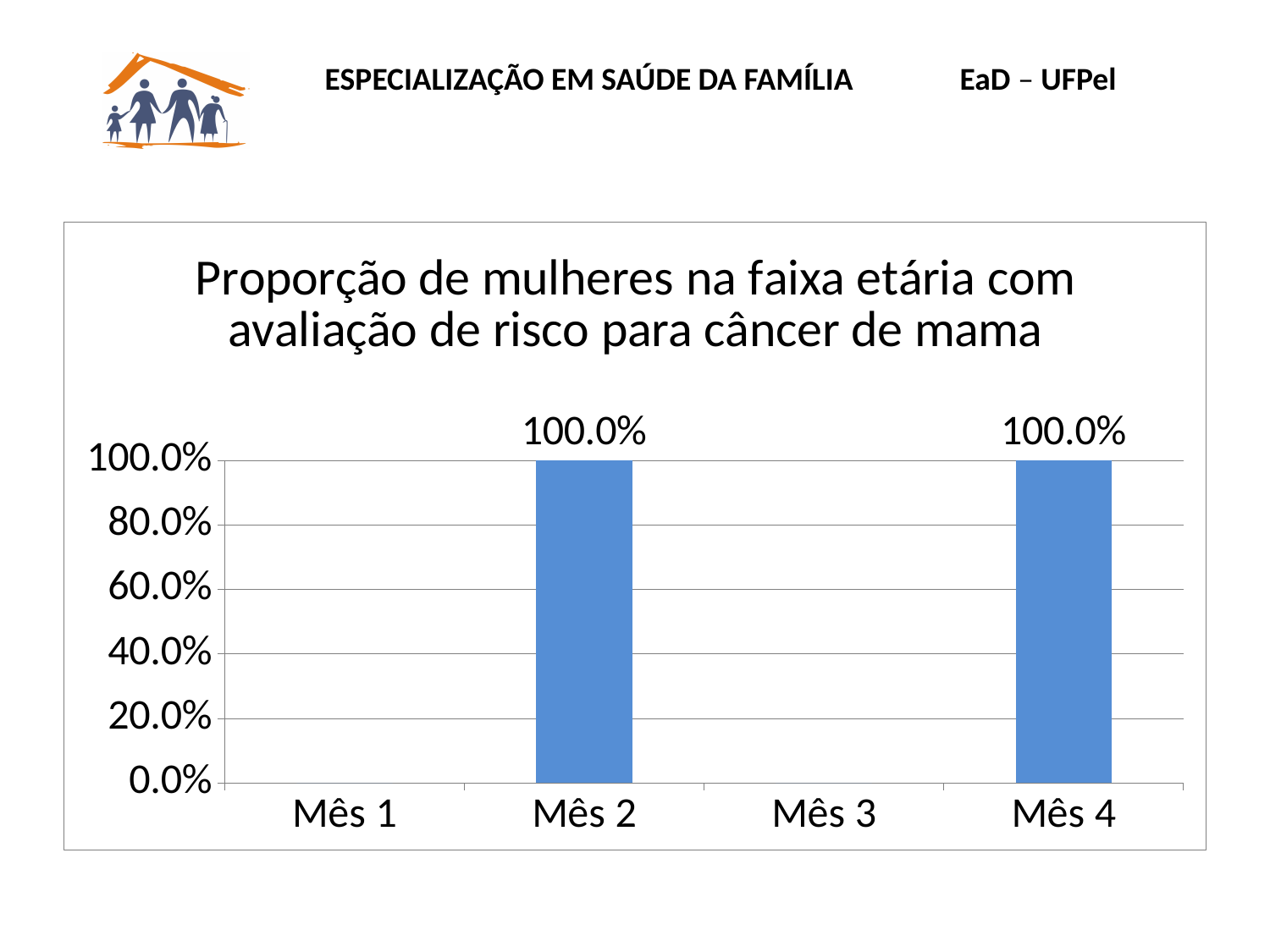
What is the difference between the values for Mês 2 and Mês 4? 0.0% Which is larger, the value for Mês 4 or the value for Mês 3? Mês 4 What is the value for Mês 2? 100.0% Which is larger, the value for Mês 2 or the value for Mês 1? Mês 2 What is the title of the chart? Proporção de mulheres na faixa etária com avaliação de risco para câncer de mama Is the value for Mês 2 greater or less than 80.0%? greater How many categories are shown on the x axis? 4 Which categories have a visible bar in the chart? Mês 2 and Mês 4 What is the value for Mês 4? 100.0% Is the value for Mês 4 greater or less than 60.0%? greater What is the highest value shown on the y axis? 100.0% What kind of chart is shown on the slide? Bar chart